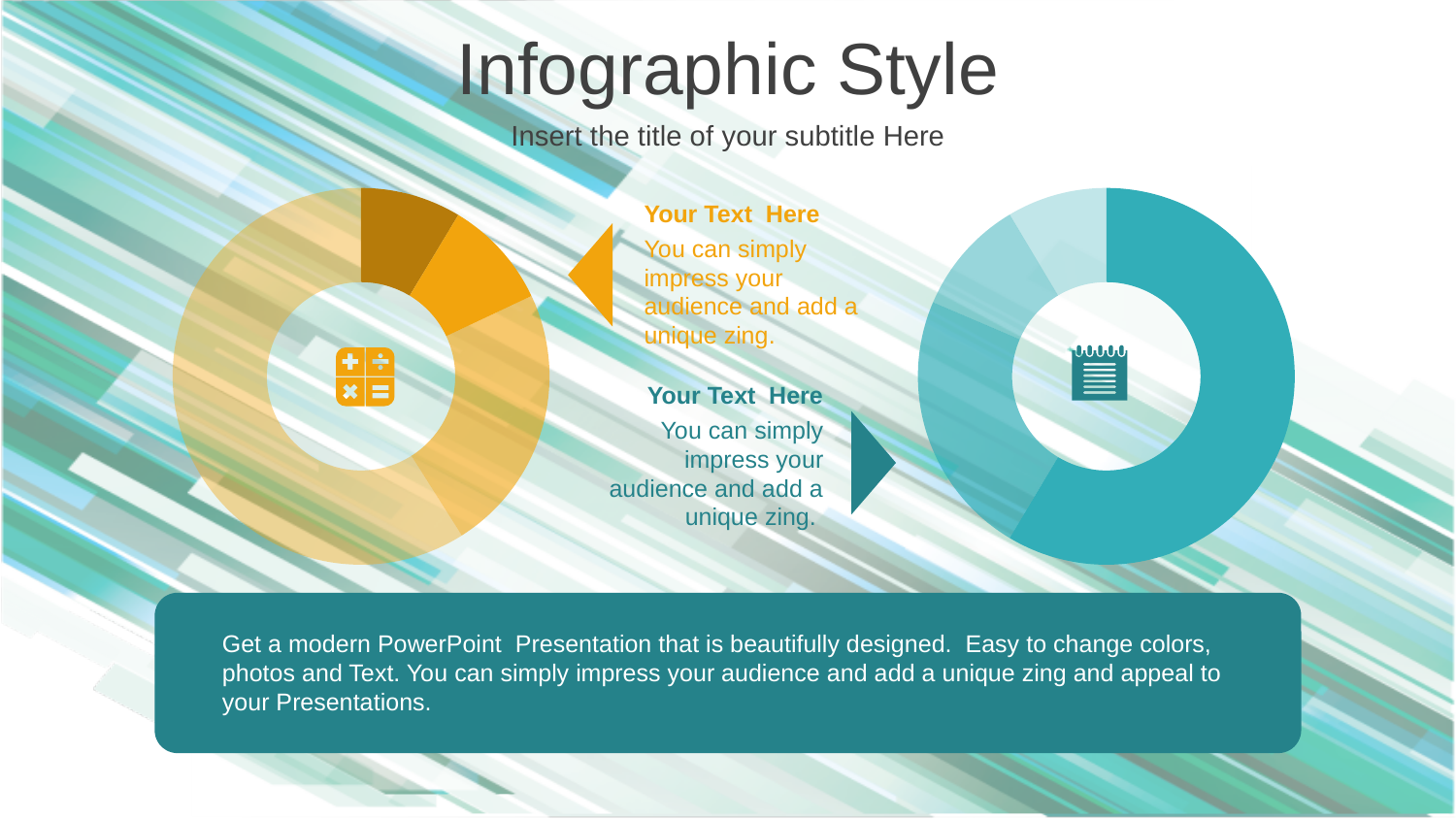
In the right-hand doughnut chart, which slice is the largest? The dark teal slice What colour scheme is used for the left-hand doughnut chart? Orange What kind of chart is shown on the right side of the slide? Doughnut chart What kind of chart is shown on the left side of the slide? Doughnut chart What colour scheme is used for the right-hand doughnut chart? Teal In the right-hand doughnut chart, is the dark teal slice larger or smaller than all the lighter slices combined? Larger